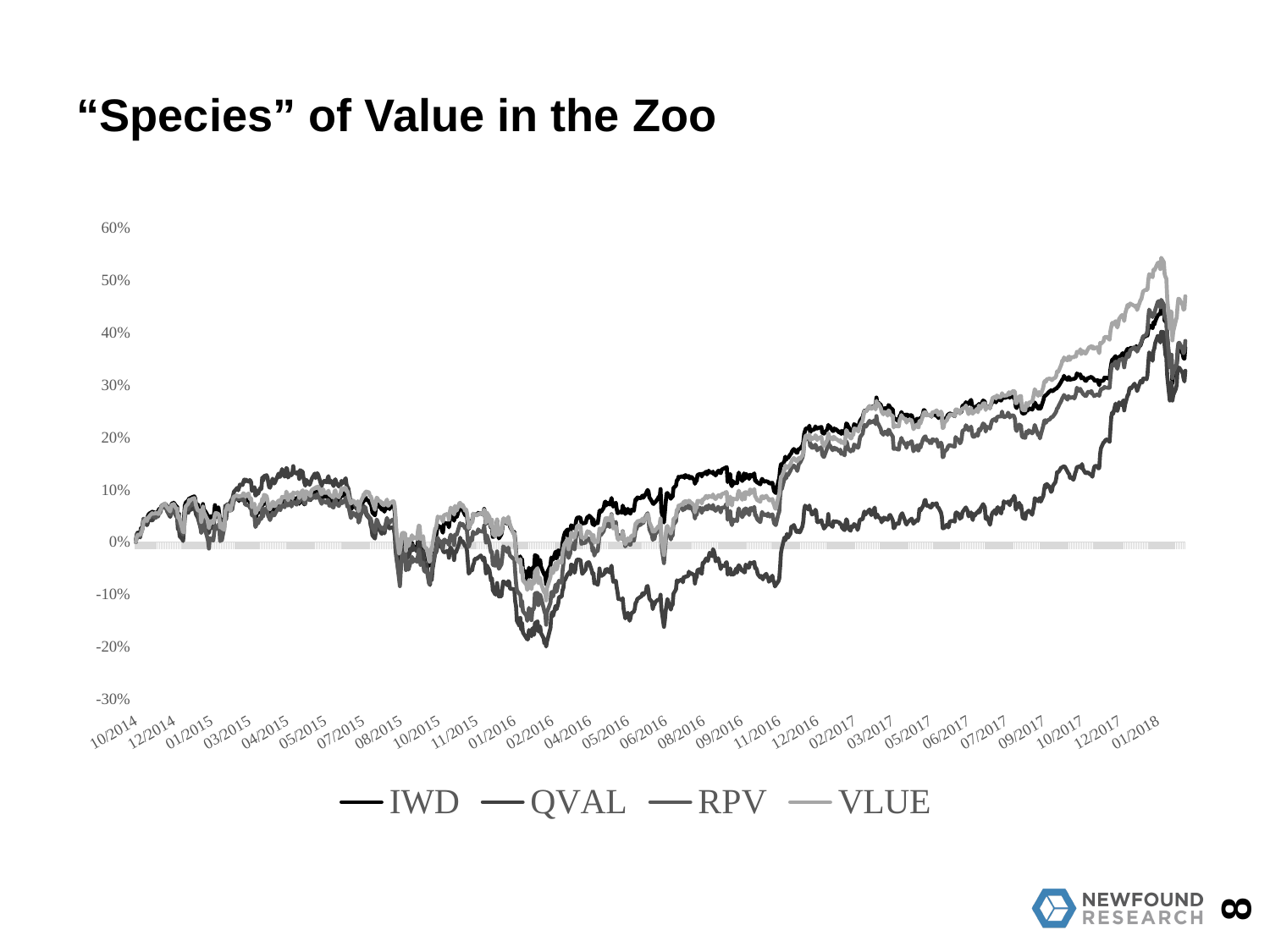
At the end of the chart (01/2018), are all series values greater or less than 20%? greater Is the value of the series at the start of the chart (10/2014) greater or less than 10%? less What are the series names listed in the legend? IWD, QVAL, RPV, VLUE Is the highest value reached by any series on the chart greater or less than 50%? greater What is the title of the slide containing the chart? "Species" of Value in the Zoo Overall, do the series values rise or fall from 10/2014 to 01/2018? rise What kind of chart is shown on the slide? line chart How many series does the legend list? 4